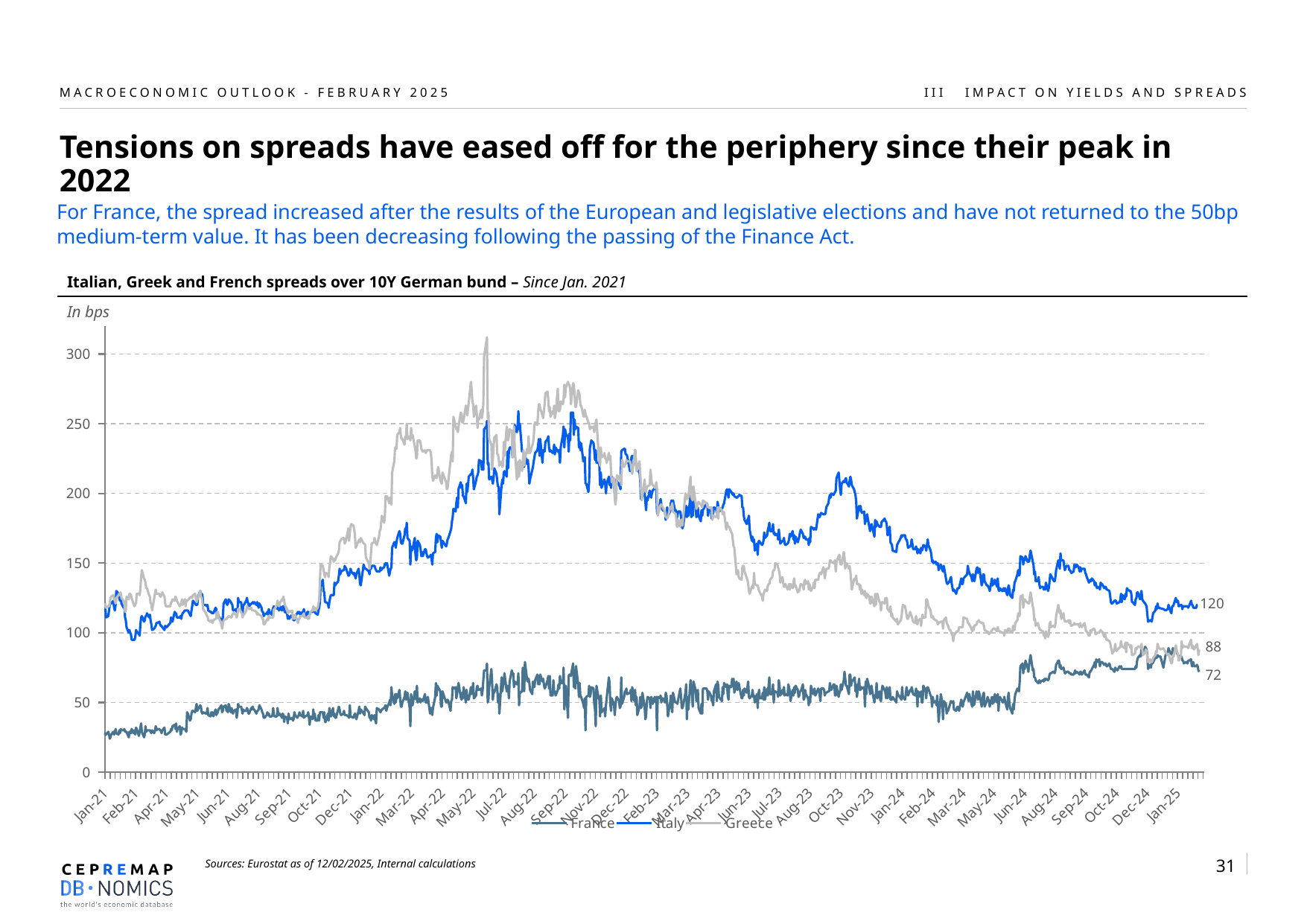
At the right end of the chart, which is larger: the value for Italy or the value for Greece? Italy Which series has the highest value at the right end of the chart? Italy What is the latest value shown for Italy at the right end of the chart? 120 How many series does the legend list? 3 What is the latest value shown for Greece at the right end of the chart? 88 Is the value for France in Jan-21 greater or less than 50? less What is the latest value shown for France at the right end of the chart? 72 Is the peak value for Greece in 2022 greater or less than 300? greater What is the difference between the latest values for Italy and France? 48 What is the difference between the latest values for Greece and France? 16 What kind of chart is shown on the slide? Line chart Which series has the lowest value at the right end of the chart? France